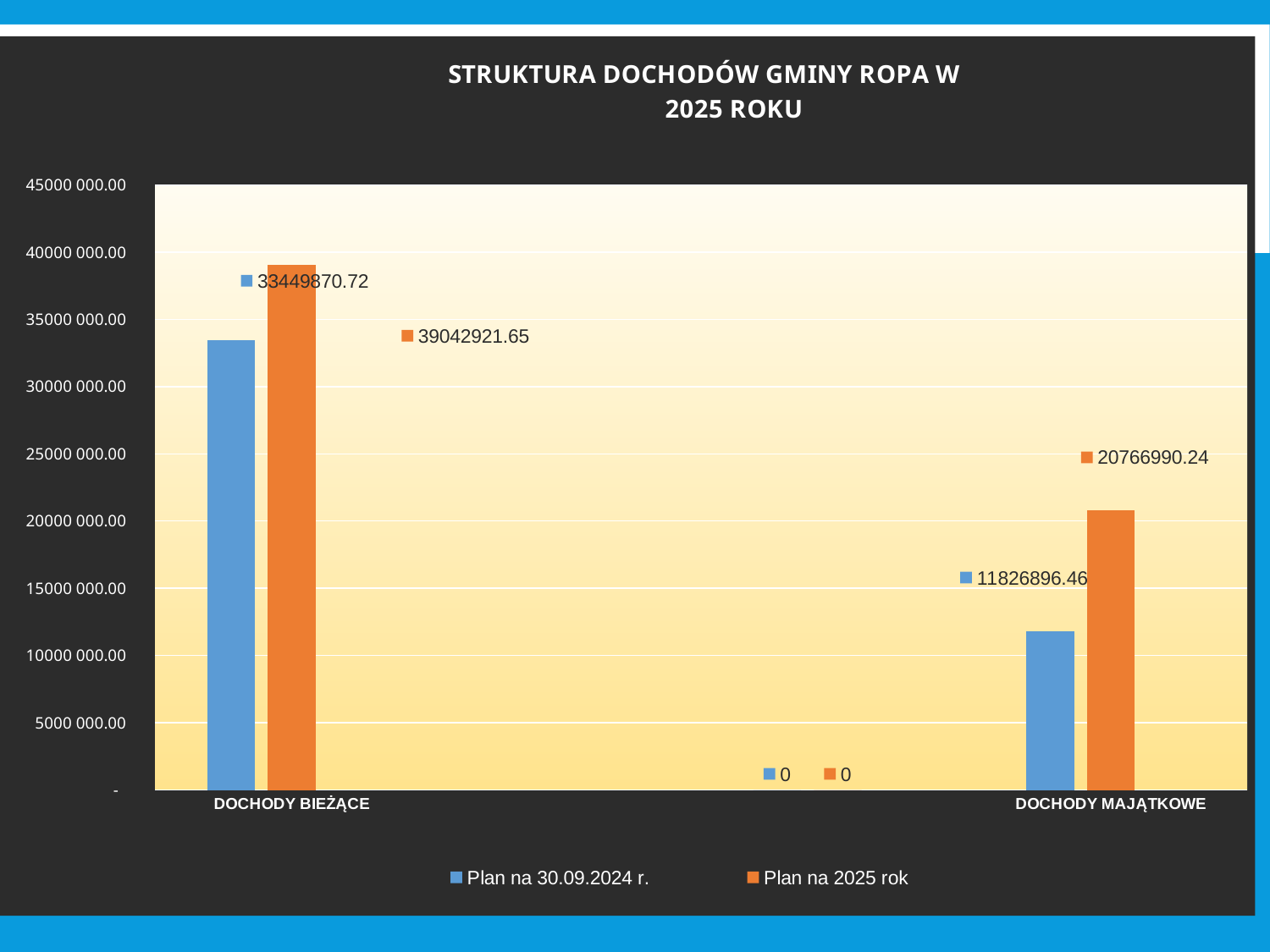
What is the value of Plan na 2025 rok for DOCHODY MAJĄTKOWE? 20766990.24 For DOCHODY MAJĄTKOWE, which is larger: Plan na 30.09.2024 r. or Plan na 2025 rok? Plan na 2025 rok Which category has the highest value for Plan na 2025 rok? DOCHODY BIEŻĄCE What is the value of Plan na 30.09.2024 r. for DOCHODY BIEŻĄCE? 33449870.72 What is the difference between Plan na 2025 rok and Plan na 30.09.2024 r. for DOCHODY MAJĄTKOWE? 8940093.78 What kind of chart is shown on the slide? bar chart What is the value of Plan na 2025 rok for DOCHODY BIEŻĄCE? 39042921.65 Is the value of Plan na 30.09.2024 r. for DOCHODY BIEŻĄCE greater or less than 30000 000.00? greater What is the value of Plan na 30.09.2024 r. for DOCHODY MAJĄTKOWE? 11826896.46 What is the difference between Plan na 2025 rok and Plan na 30.09.2024 r. for DOCHODY BIEŻĄCE? 5593050.93 How many series does the legend list? 2